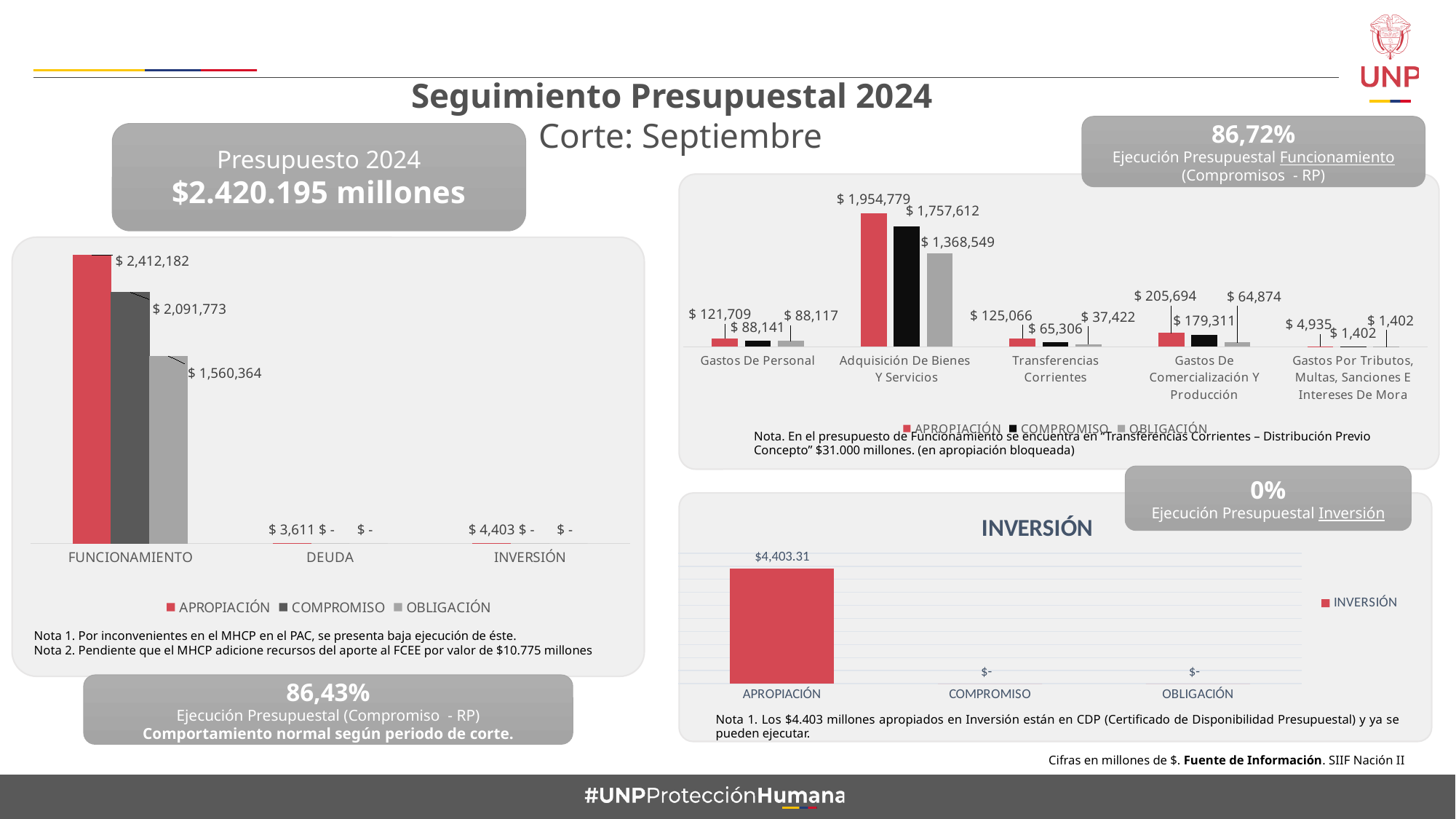
In the bottom-left chart, what is the APROPIACIÓN value for FUNCIONAMIENTO? $ 2,412,182 In the top-right chart, what is the OBLIGACIÓN value for Gastos De Comercialización Y Producción? $ 64,874 In the bottom-left chart, how many series does the legend list? 3 In the top-right chart, which category has the highest APROPIACIÓN value? Adquisición De Bienes Y Servicios In the bottom-left chart, what is the OBLIGACIÓN value for FUNCIONAMIENTO? $ 1,560,364 In the INVERSIÓN chart at the bottom right, what is the APROPIACIÓN value? $4,403.31 In the top-right chart, what is the COMPROMISO value for Adquisición De Bienes Y Servicios? $ 1,757,612 In the top-right chart, which category has the lowest APROPIACIÓN value? Gastos Por Tributos, Multas, Sanciones E Intereses De Mora In the bottom-left chart, what is the APROPIACIÓN value for DEUDA? $ 3,611 In the top-right chart, how many categories are shown on the x axis? 5 What kind of chart is the INVERSIÓN chart at the bottom right? Bar chart In the bottom-left chart, what is the difference between the APROPIACIÓN and COMPROMISO values for FUNCIONAMIENTO? $ 320,409